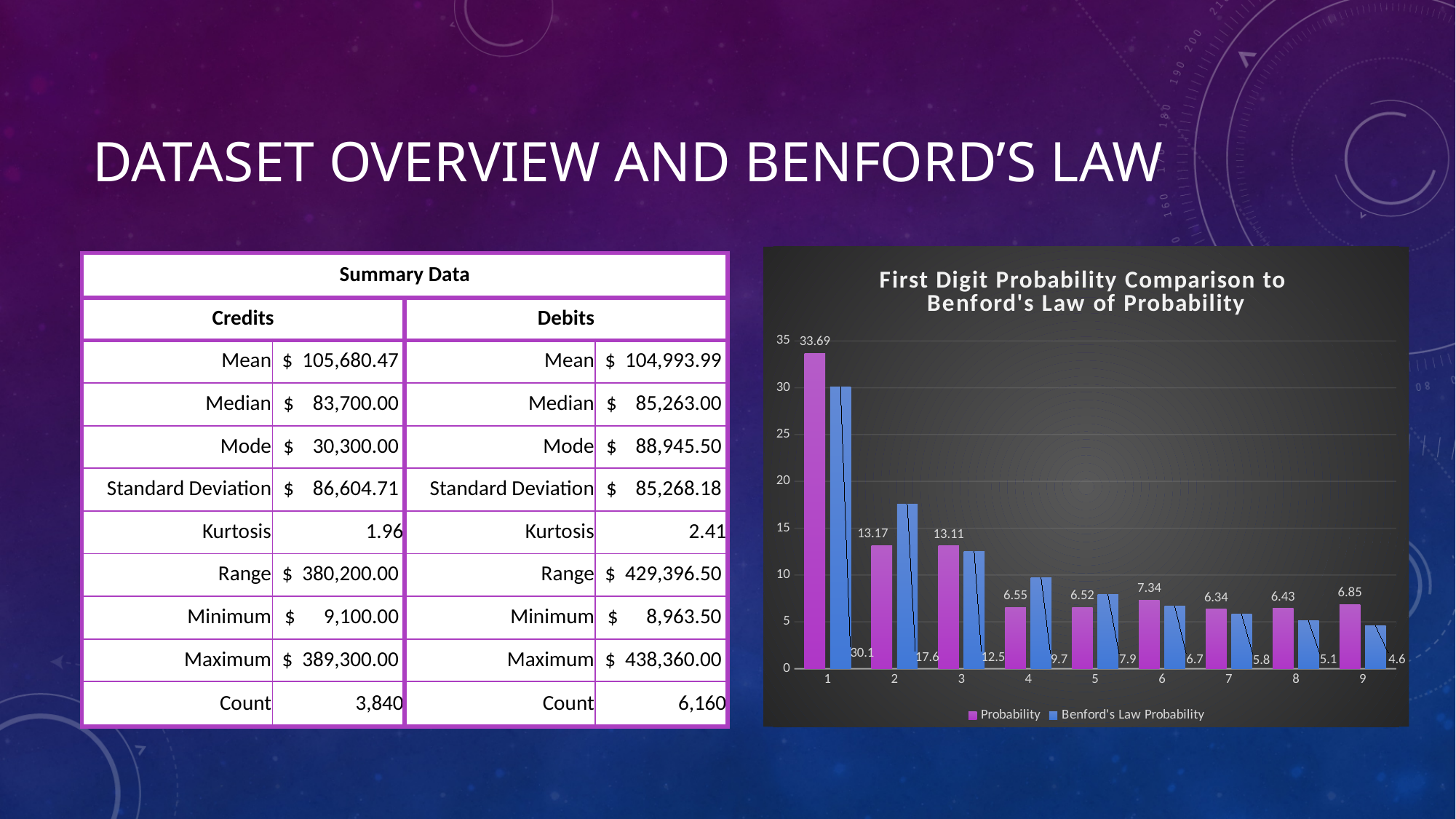
How many series does the legend list? 2 Which digit has the highest Probability value? 1 What is the difference between the Probability and Benford's Law Probability values for digit 1? 3.59 What kind of chart is shown on the slide? Bar chart What is the Probability value for digit 6? 7.34 Do the Benford's Law Probability values rise or fall from digit 1 to digit 9? Fall What is the Probability value for digit 1? 33.69 What is the Benford's Law Probability value for digit 9? 4.6 For digit 2, which is larger: the Probability value or the Benford's Law Probability value? Benford's Law Probability Which digit has the lowest Benford's Law Probability value? 9 What is the Benford's Law Probability value for digit 2? 17.6 How many digit categories are shown on the x axis? 9